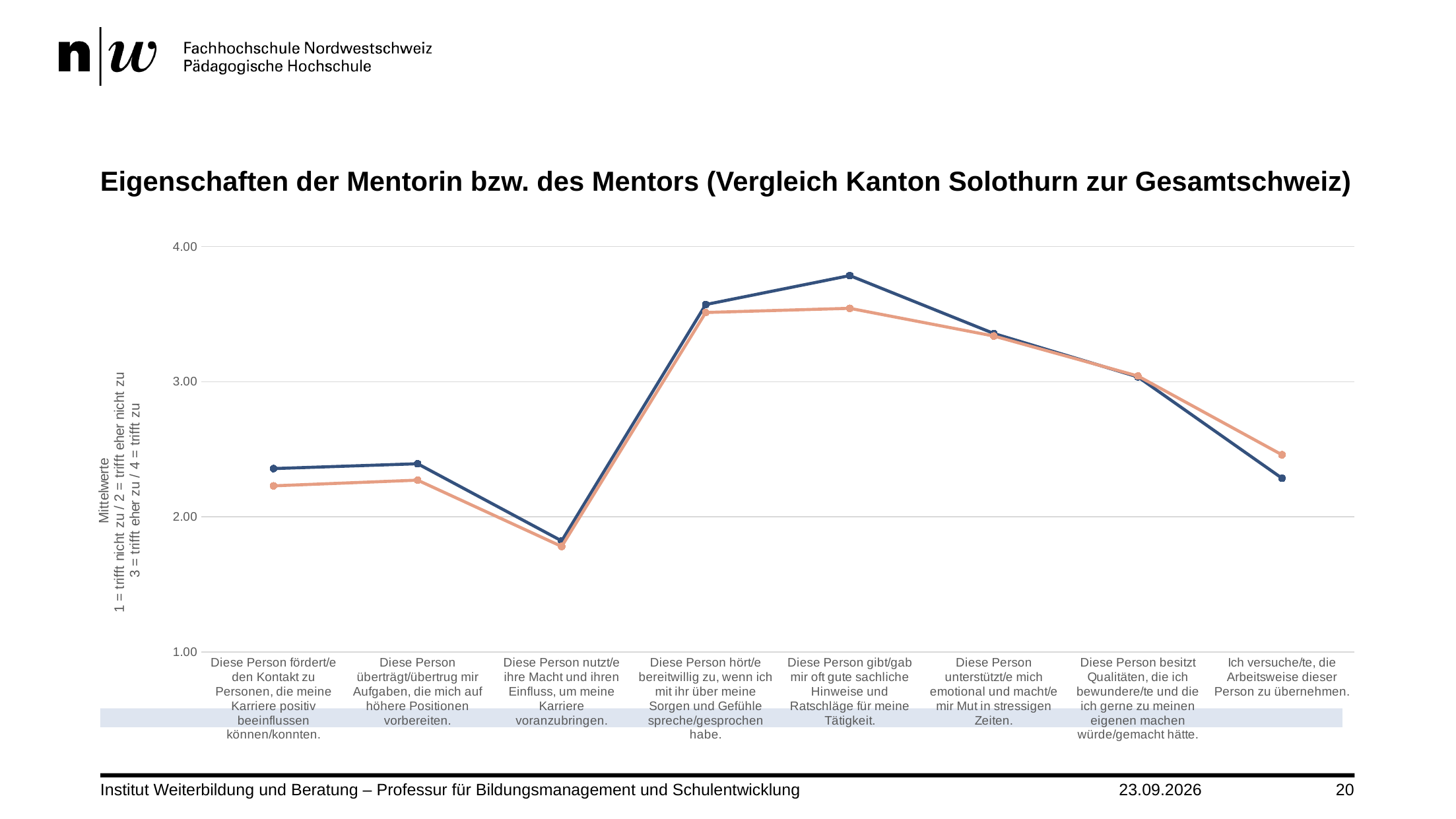
Is the orange value for "Ich versuche/te, die Arbeitsweise dieser Person zu übernehmen." greater or less than 2.00? greater For "Ich versuche/te, die Arbeitsweise dieser Person zu übernehmen.", which line is higher, the dark blue or the orange one? orange For which statement does the dark blue line reach its highest value? Diese Person gibt/gab mir oft gute sachliche Hinweise und Ratschläge für meine Tätigkeit. What is the title of the chart? Eigenschaften der Mentorin bzw. des Mentors (Vergleich Kanton Solothurn zur Gesamtschweiz) Does the dark blue line rise or fall from "Diese Person gibt/gab mir oft gute sachliche Hinweise und Ratschläge für meine Tätigkeit." to "Ich versuche/te, die Arbeitsweise dieser Person zu übernehmen."? fall For "Diese Person gibt/gab mir oft gute sachliche Hinweise und Ratschläge für meine Tätigkeit.", which line is higher, the dark blue or the orange one? dark blue How many categories (statements) are plotted along the x axis? 8 For which statement does the orange line reach its lowest value? Diese Person nutzt/e ihre Macht und ihren Einfluss, um meine Karriere voranzubringen. Is the dark blue value for "Diese Person gibt/gab mir oft gute sachliche Hinweise und Ratschläge für meine Tätigkeit." greater or less than 3.00? greater Is the orange value for "Diese Person nutzt/e ihre Macht und ihren Einfluss, um meine Karriere voranzubringen." greater or less than 2.00? less What kind of chart is shown on the slide? line chart For which statement does the dark blue line reach its lowest value? Diese Person nutzt/e ihre Macht und ihren Einfluss, um meine Karriere voranzubringen.